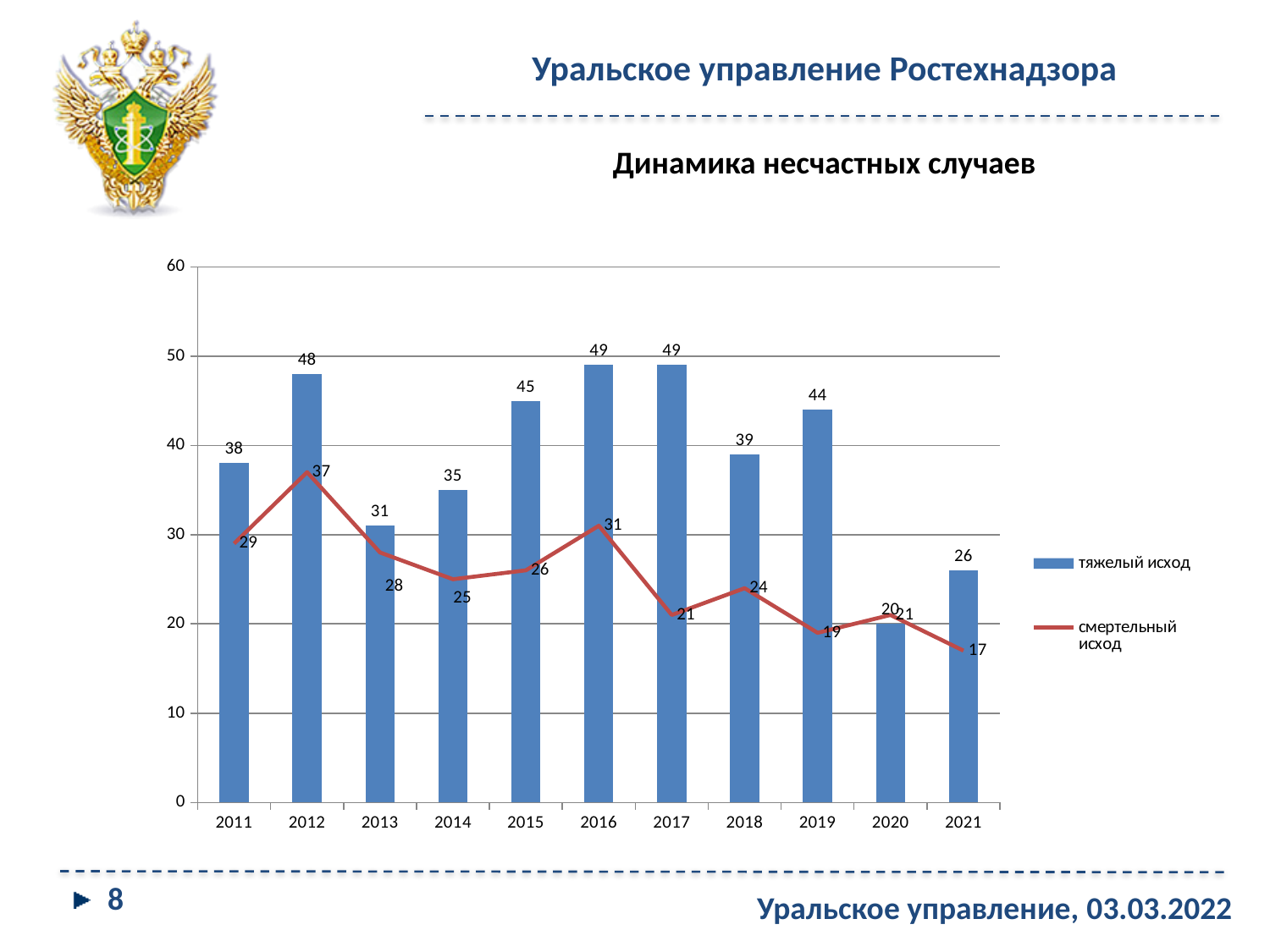
Which is larger in 2014: тяжелый исход or смертельный исход? тяжелый исход What is the value for смертельный исход in 2012? 37 How many years are shown on the x axis? 11 What kind of chart is used for the series тяжелый исход? bar chart Which year has the highest value for смертельный исход? 2012 What is the title of the chart? Динамика несчастных случаев What is the value for тяжелый исход in 2015? 45 Which year has the lowest value for смертельный исход? 2021 How many series does the legend list? 2 What is the value for тяжелый исход in 2021? 26 What is the difference between тяжелый исход and смертельный исход in 2019? 25 Which year has the lowest value for тяжелый исход? 2020